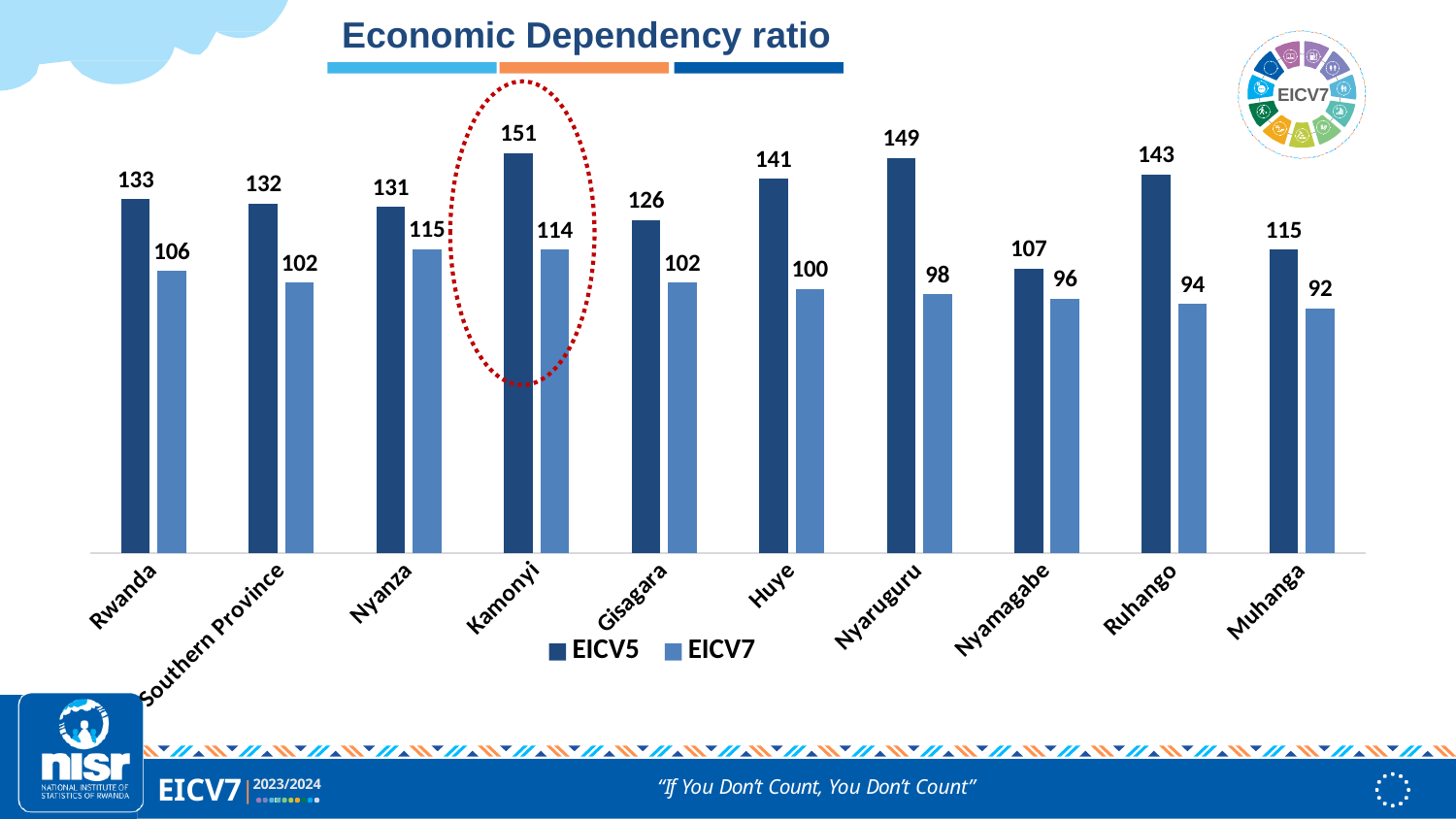
How many series does the legend list? 2 What kind of chart is shown on the slide? Bar chart Which is larger, the EICV5 value for Huye or the EICV5 value for Nyaruguru? Nyaruguru What is the EICV7 value for Nyaruguru? 98 What is the difference between the EICV5 and EICV7 values for Ruhango? 49 How many categories are shown on the x axis? 10 Which category has the lowest EICV7 value? Muhanga Which category has the lowest EICV5 value? Nyamagabe What is the EICV7 value for Rwanda? 106 What is the title of the chart? Economic Dependency ratio What is the EICV5 value for Kamonyi? 151 Which category has the highest EICV5 value? Kamonyi